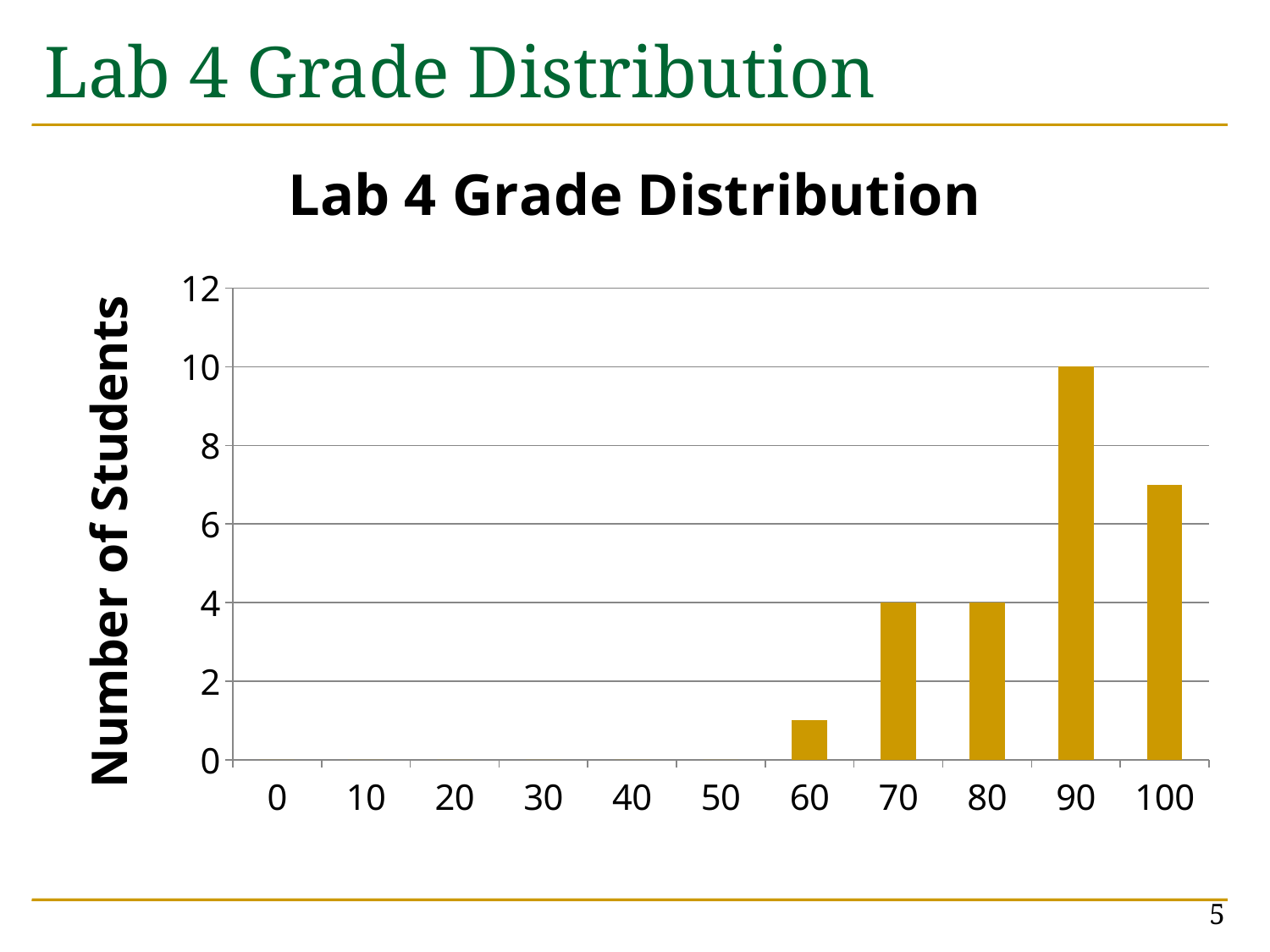
What kind of chart is shown on the slide? bar chart What is the label of the vertical axis? Number of Students Which grade has the highest number of students? 90 What is the difference between the number of students at grade 90 and at grade 70? 6 How many students are shown for the grade 80? 4 Is the number of students for grade 60 greater or less than 2? less How many students are shown for the grade 90? 10 How many grade categories are labelled on the x axis? 11 Which has more students, grade 90 or grade 100? 90 Is the number of students for grade 100 greater or less than 6? greater What is the title of the chart? Lab 4 Grade Distribution How many students are shown for the grade 70? 4